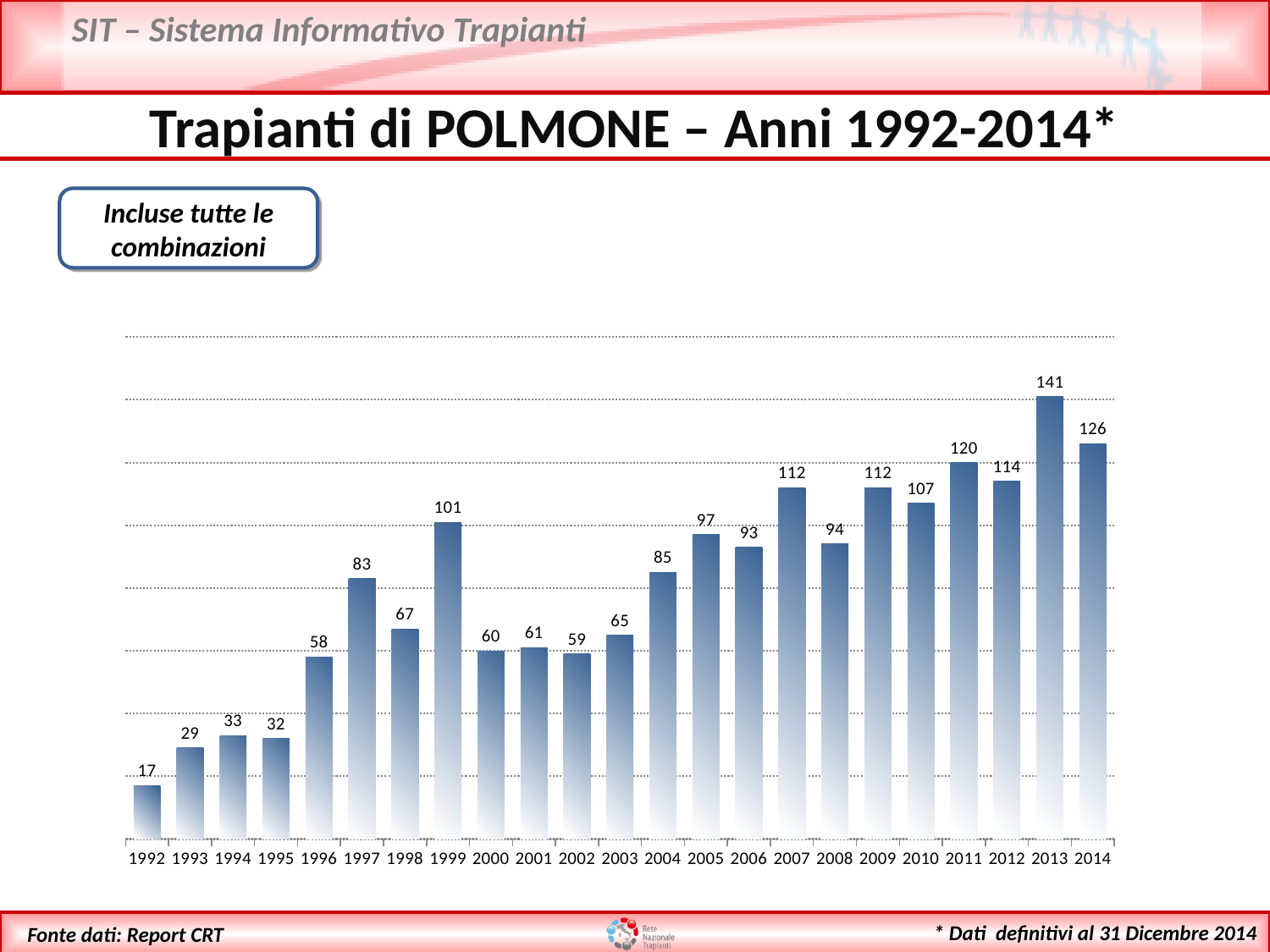
What is the difference between the values for 2013 and 2014? 15 Which year has the highest value? 2013 How many years are shown on the x axis? 23 What is the value for 1992? 17 What kind of chart is shown on the slide? bar chart What is the title of the chart on the slide? Trapianti di POLMONE – Anni 1992-2014* What is the value for 2014? 126 Do the values generally rise or fall from 1992 to 2014? rise What is the difference between the values for 1999 and 2000? 41 What is the value for 1999? 101 Which year has the lowest value? 1992 Which is larger, the value for 1997 or the value for 2004? 2004